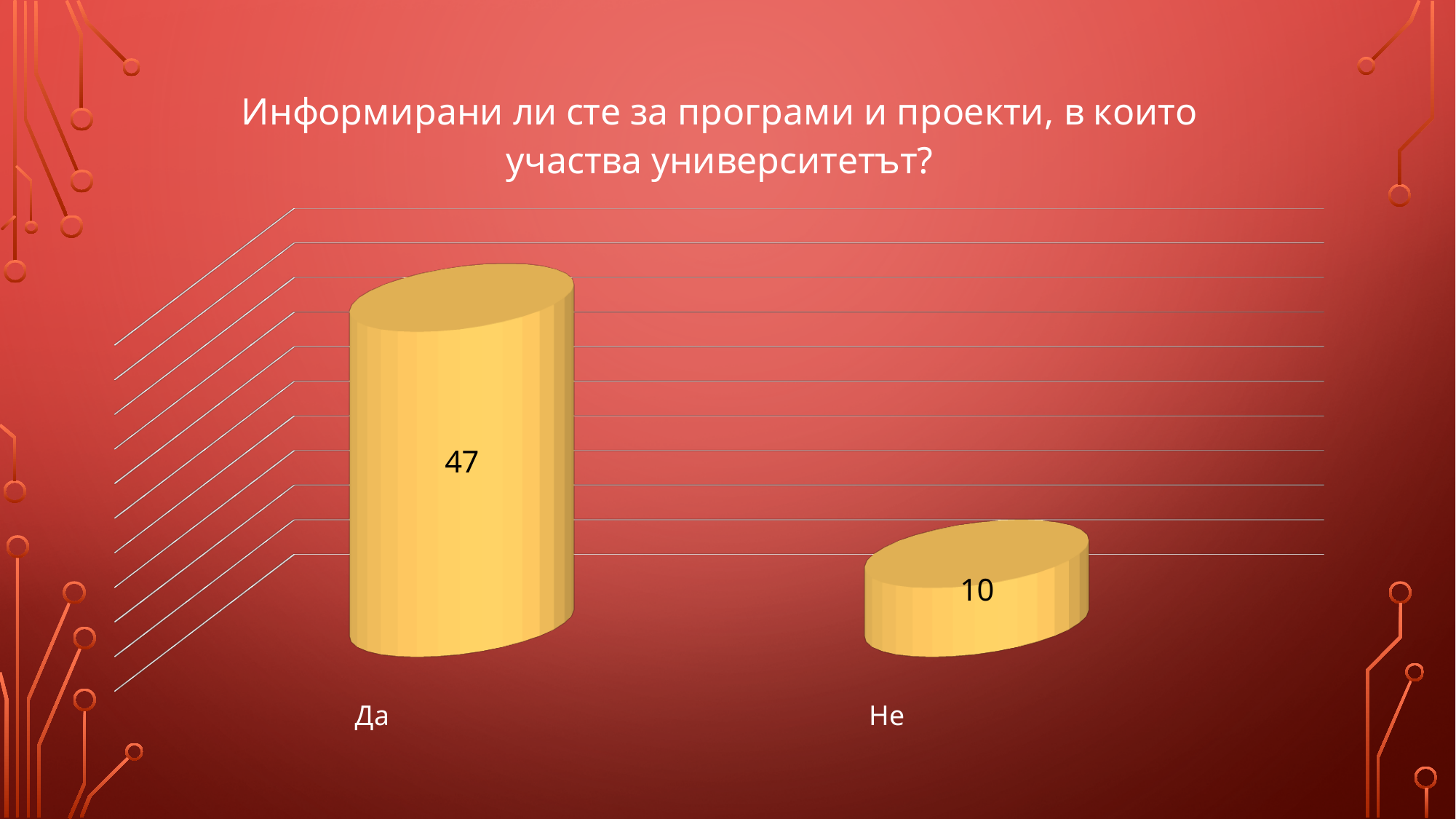
What colour are the bars in the chart? Yellow Which is larger, the value for "Да" or the value for "Не"? Да What kind of chart is shown on the slide? Bar chart What is the difference between the values for "Да" and "Не"? 37 How many categories are shown in the chart? 2 What is the title of the chart? Информирани ли сте за програми и проекти, в които участва университетът? What is the total of the two values shown in the chart? 57 Which category has the lowest value? Не Which category has the highest value? Да What is the value for "Да"? 47 What is the value for "Не"? 10